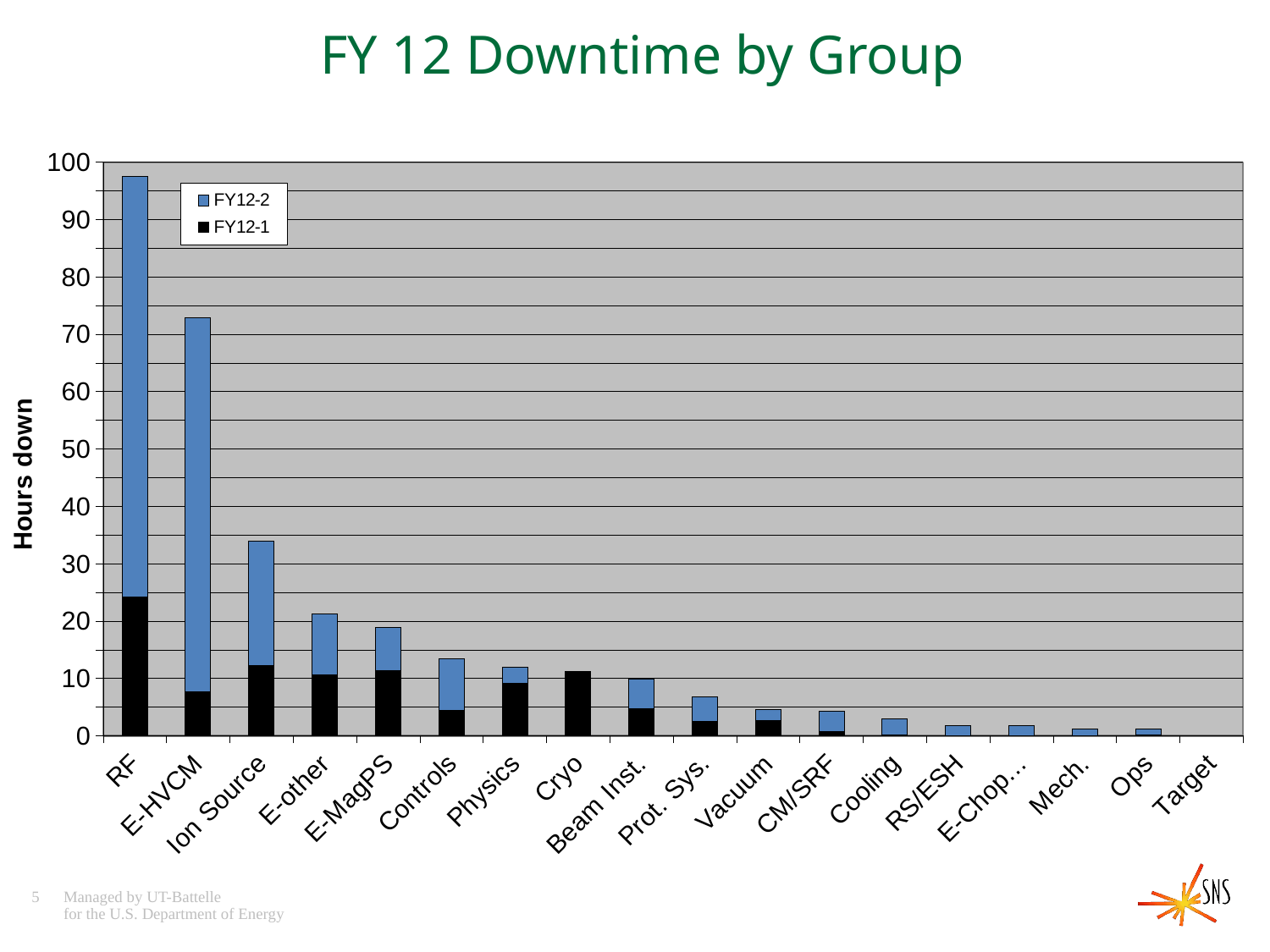
Which group has the lowest total hours down? Target Is the total value for Ion Source greater or less than 30? greater What kind of chart is shown on the slide? Stacked bar chart What is the label on the vertical axis? Hours down How many series does the legend list? 2 Is the total value for Cooling greater or less than 10? less Is the total value for RF greater or less than 90? greater Which has a larger total: RF or E-HVCM? RF How many groups are shown along the x axis? 18 Do the total hours down generally rise or fall moving from left to right along the x axis? Fall Which group has the highest total hours down? RF